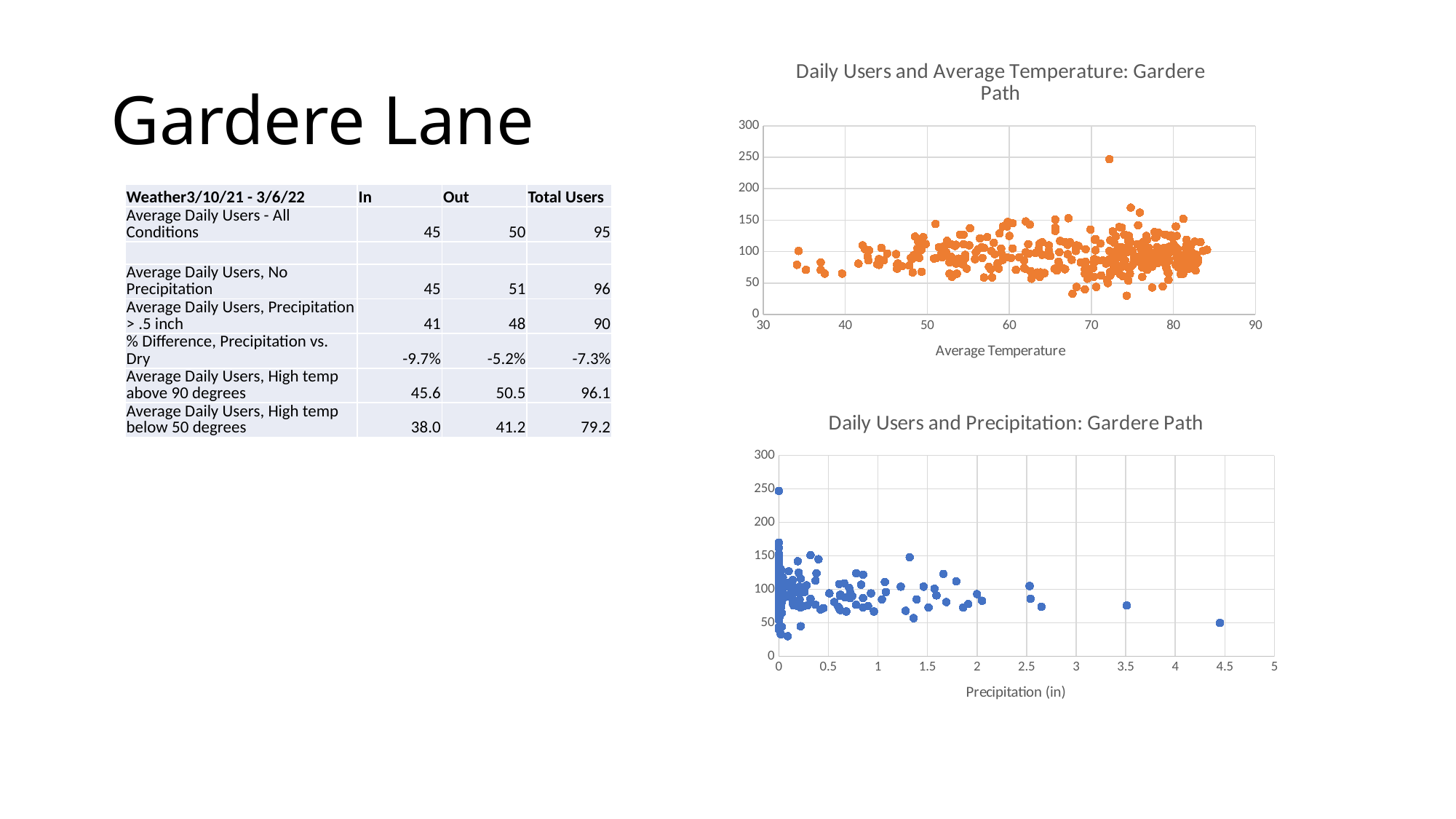
In the bottom chart, 'Daily Users and Precipitation: Gardere Path', is the point near 3.5 inches of precipitation greater or less than 100 daily users? less In the bottom chart, 'Daily Users and Precipitation: Gardere Path', is the highest point greater or less than 200? greater What is the x-axis label of the bottom chart, 'Daily Users and Precipitation: Gardere Path'? Precipitation (in) In the top chart, 'Daily Users and Average Temperature: Gardere Path', is the point with the highest average temperature greater or less than 150 daily users? less What is the title of the top chart on the slide? Daily Users and Average Temperature: Gardere Path What kind of chart is the top chart, 'Daily Users and Average Temperature: Gardere Path'? scatter chart What kind of chart is the bottom chart, 'Daily Users and Precipitation: Gardere Path'? scatter chart